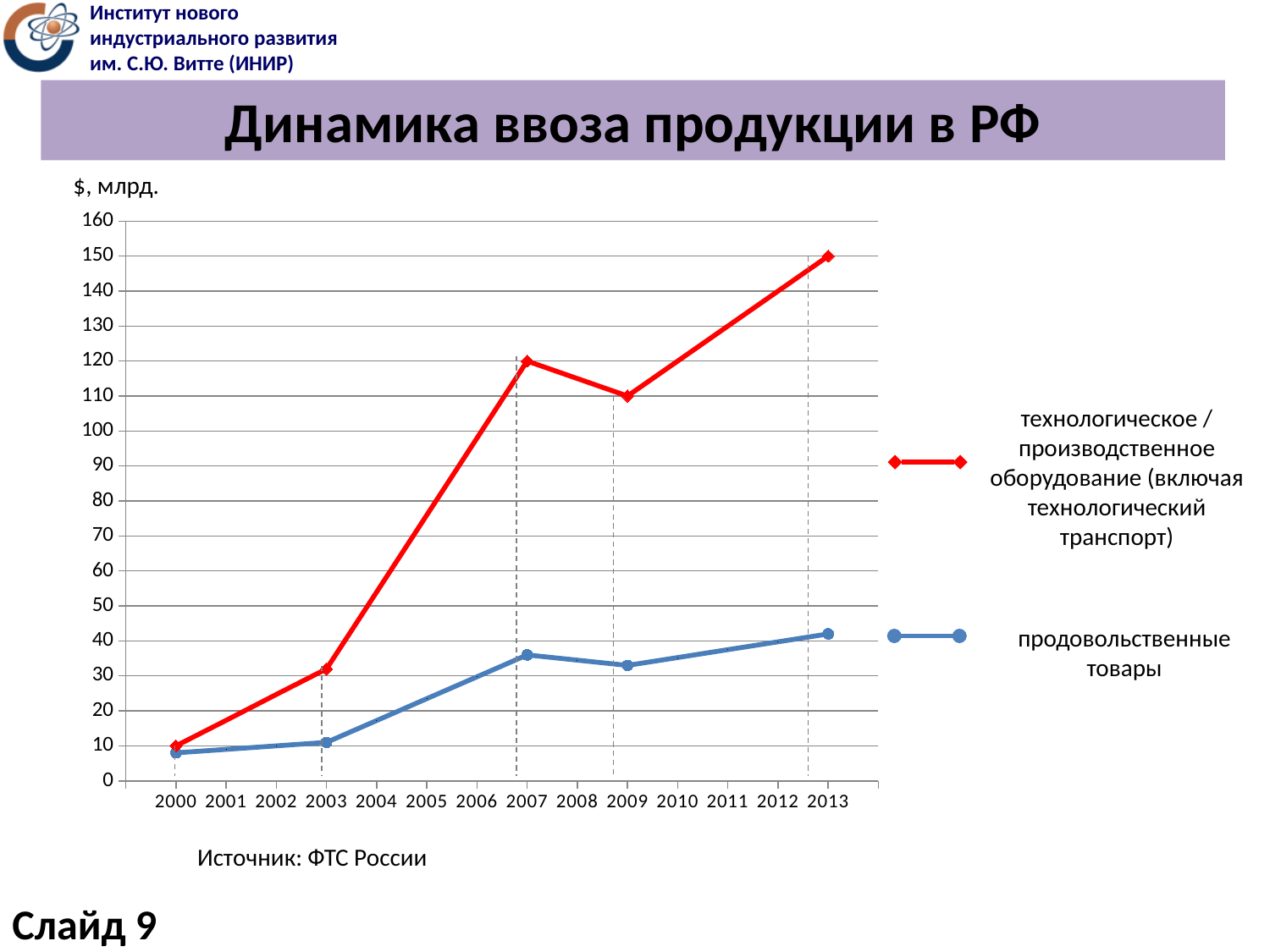
What is the value for 'технологическое / производственное оборудование' in 2007? 120 What is the value for 'технологическое / производственное оборудование' in 2009? 110 How many series does the legend list? 2 What is the value for 'технологическое / производственное оборудование' in 2013? 150 What kind of chart is shown on the slide? line chart In which year is the 'продовольственные товары' series lowest? 2000 Is the value for 'продовольственные товары' in 2013 greater or less than 50? less Which series has the larger value in 2013, 'технологическое / производственное оборудование' or 'продовольственные товары'? технологическое / производственное оборудование What is the title of the chart? Динамика ввоза продукции в РФ In which year is the 'технологическое / производственное оборудование' series highest? 2013 By how much did the 'технологическое / производственное оборудование' value change from 2007 to 2013? 30